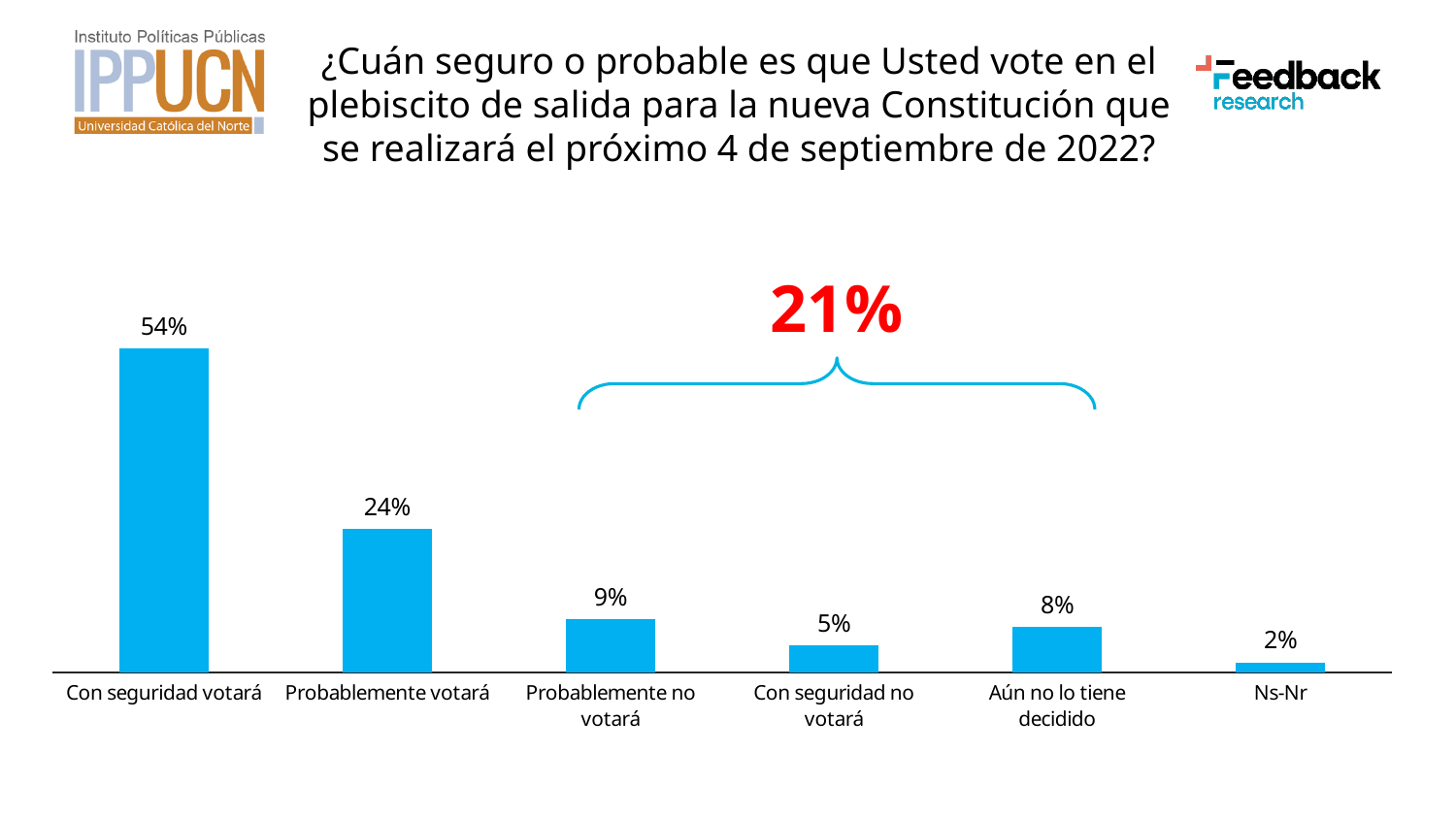
Which category has the highest value? Con seguridad votará Which is larger, "Probablemente no votará" or "Aún no lo tiene decidido"? Probablemente no votará What kind of chart is shown on the slide? Bar chart What is the value for "Aún no lo tiene decidido"? 8% How many categories are shown on the chart? 6 Which category has the lowest value? Ns-Nr What is the difference between "Probablemente no votará" and "Con seguridad no votará"? 4% What is the difference between "Con seguridad votará" and "Probablemente votará"? 30% What is the value for "Probablemente votará"? 24% What percentage is shown in red above the bracket grouping the middle categories? 21% What is the value for "Ns-Nr"? 2% What is the value for "Con seguridad votará"? 54%